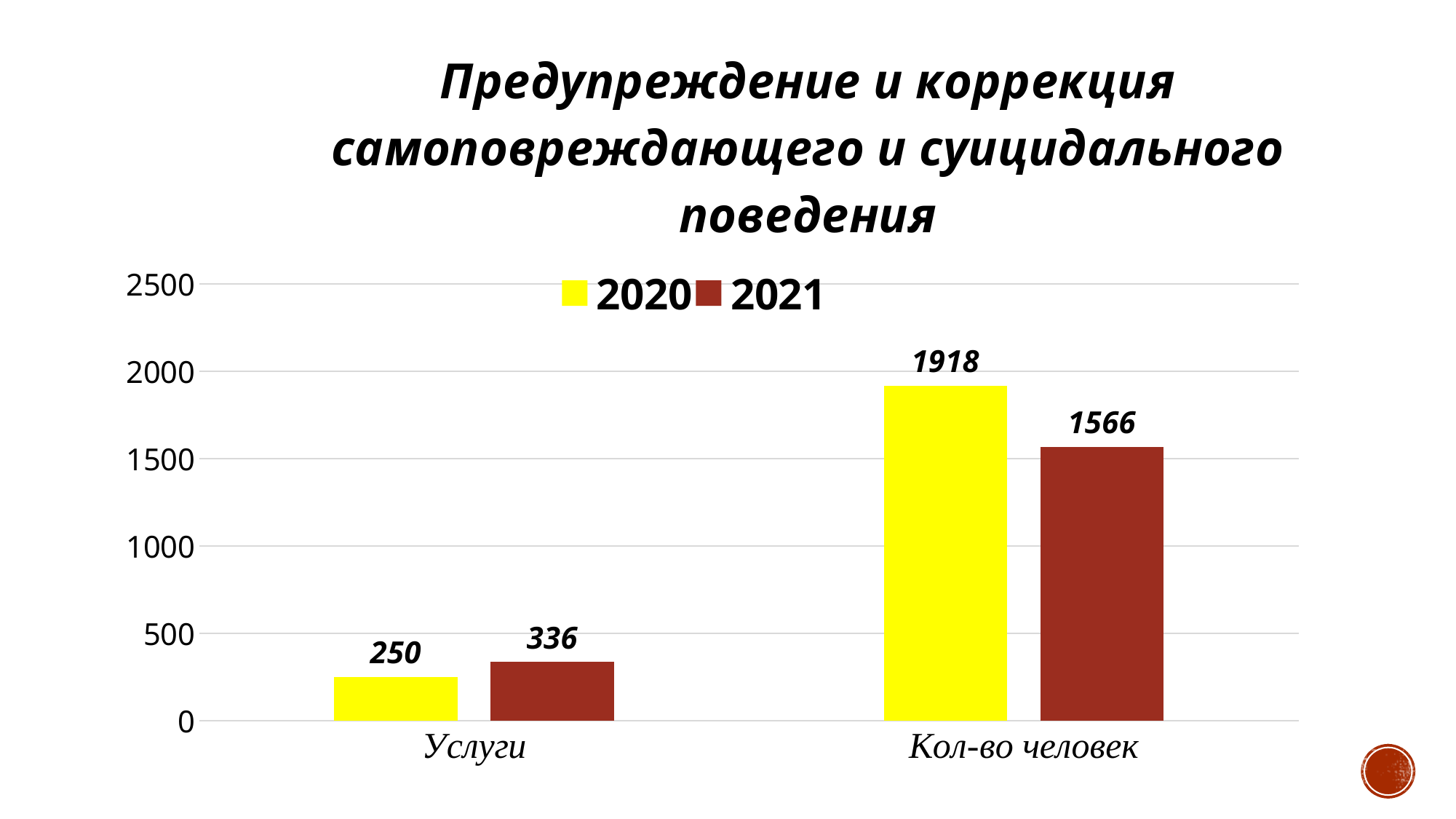
What kind of chart is shown on the slide? Bar chart How many categories are shown on the x axis? 2 Which series has the higher value for Кол-во человек, 2020 or 2021? 2020 What is the difference between the 2020 and 2021 values for Кол-во человек? 352 Which series has the higher value for Услуги, 2020 or 2021? 2021 What is the value for Кол-во человек in 2021? 1566 What is the value for Услуги in 2021? 336 What is the difference between the 2021 and 2020 values for Услуги? 86 How many series does the legend list? 2 What is the value for Кол-во человек in 2020? 1918 What is the value for Услуги in 2020? 250 Which colour represents the 2021 series in the legend? Dark red